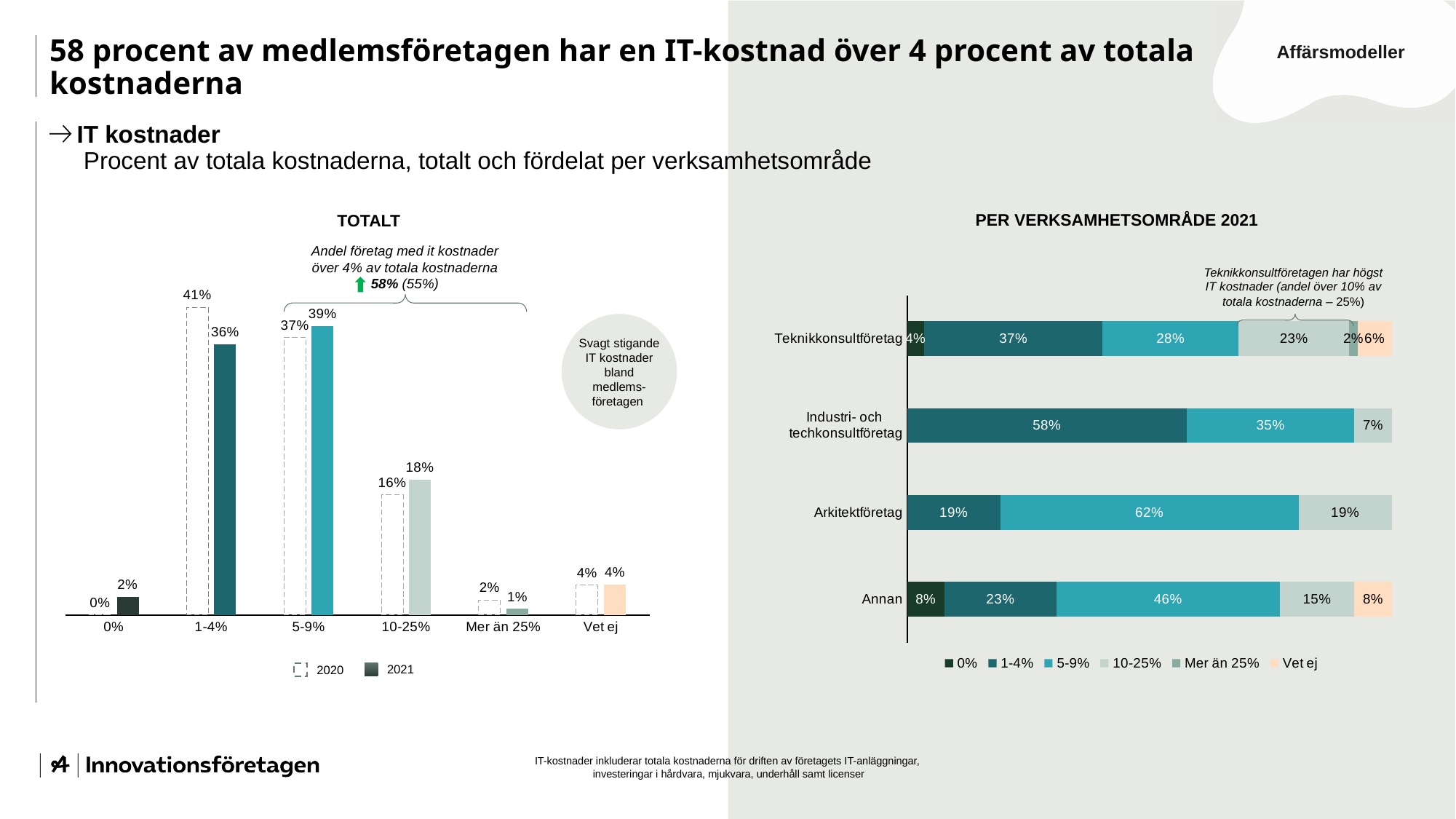
In the TOTALT chart, what is the 2021 value for the 1-4% category? 36% In the PER VERKSAMHETSOMRÅDE 2021 chart, what is the 5-9% share for Arkitektföretag? 62% In the PER VERKSAMHETSOMRÅDE 2021 chart, what is the 10-25% share for Teknikkonsultföretag? 23% In the TOTALT chart, which is larger for the 1-4% category: the 2020 value or the 2021 value? 2020 In the TOTALT chart, what is the difference between the 2020 and 2021 values for the 10-25% category? 2% In the PER VERKSAMHETSOMRÅDE 2021 chart, which is larger for Annan: the 5-9% share or the 1-4% share? 5-9% In the TOTALT chart, which category has the highest 2021 value? 5-9% How many categories are shown on the x axis of the TOTALT chart? 6 In the PER VERKSAMHETSOMRÅDE 2021 chart, what is the 1-4% share for Industri- och techkonsultföretag? 58% What type of chart is the TOTALT chart? Bar chart In the TOTALT chart, what is the 2020 value for the 5-9% category? 37% How many series does the legend of the PER VERKSAMHETSOMRÅDE 2021 chart list? 6